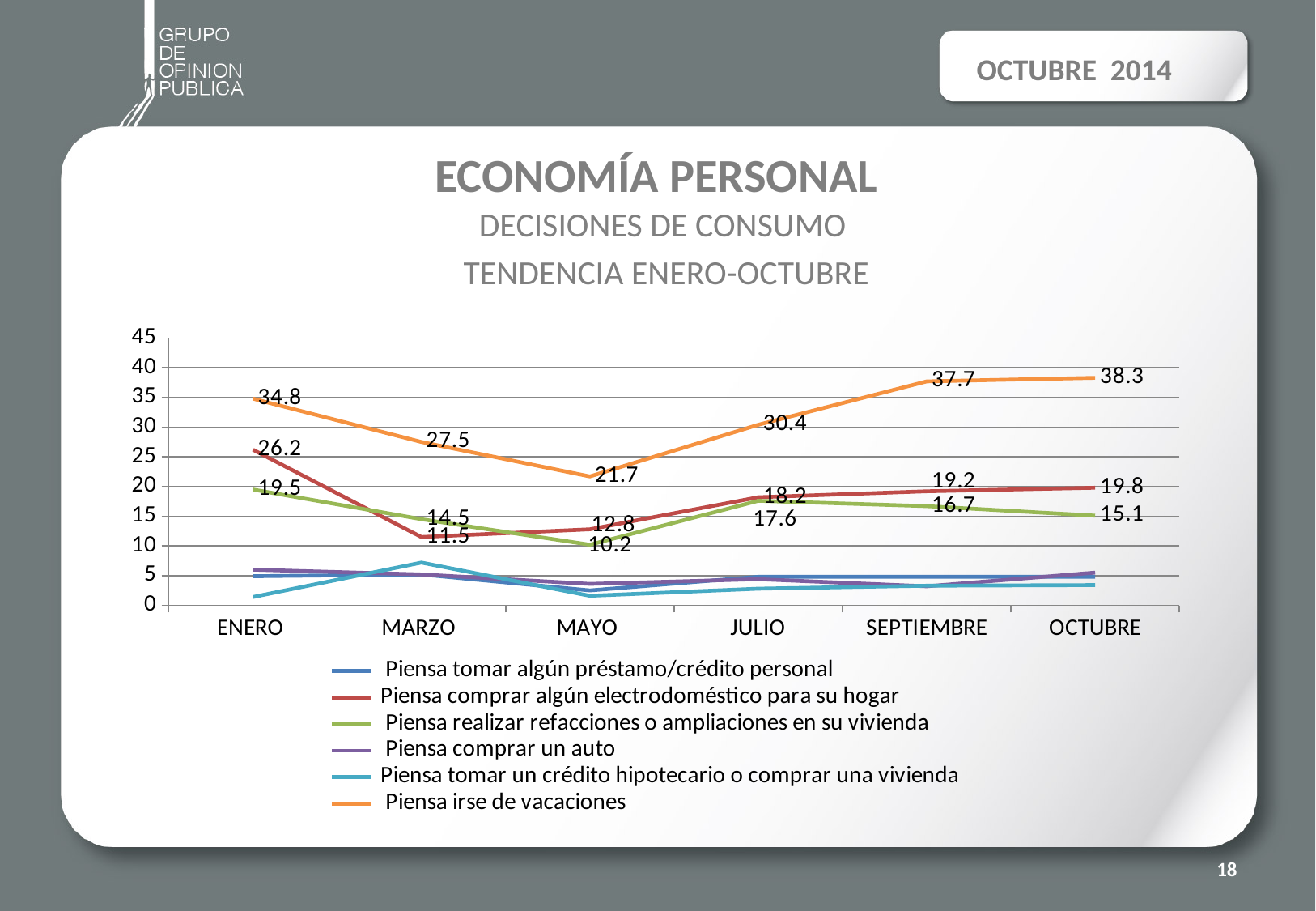
Does the 'Piensa irse de vacaciones' line rise or fall from MAYO to OCTUBRE? rise In JULIO, which is larger: the value for 'Piensa comprar algún electrodoméstico para su hogar' or for 'Piensa realizar refacciones o ampliaciones en su vivienda'? Piensa comprar algún electrodoméstico para su hogar What value does the 'Piensa comprar algún electrodoméstico para su hogar' line show for ENERO? 26.2 What value does the 'Piensa realizar refacciones o ampliaciones en su vivienda' line show for MAYO? 10.2 What kind of chart is shown on the slide? line chart How many series does the legend list? 6 How many months are shown on the x axis of the chart? 6 In which month is the 'Piensa irse de vacaciones' value highest? OCTUBRE Is the value for 'Piensa tomar un crédito hipotecario o comprar una vivienda' in ENERO greater or less than 5? less What value does the 'Piensa irse de vacaciones' line show for OCTUBRE? 38.3 In which month is the 'Piensa irse de vacaciones' value lowest? MAYO By how much does the 'Piensa irse de vacaciones' value in OCTUBRE exceed its value in ENERO? 3.5